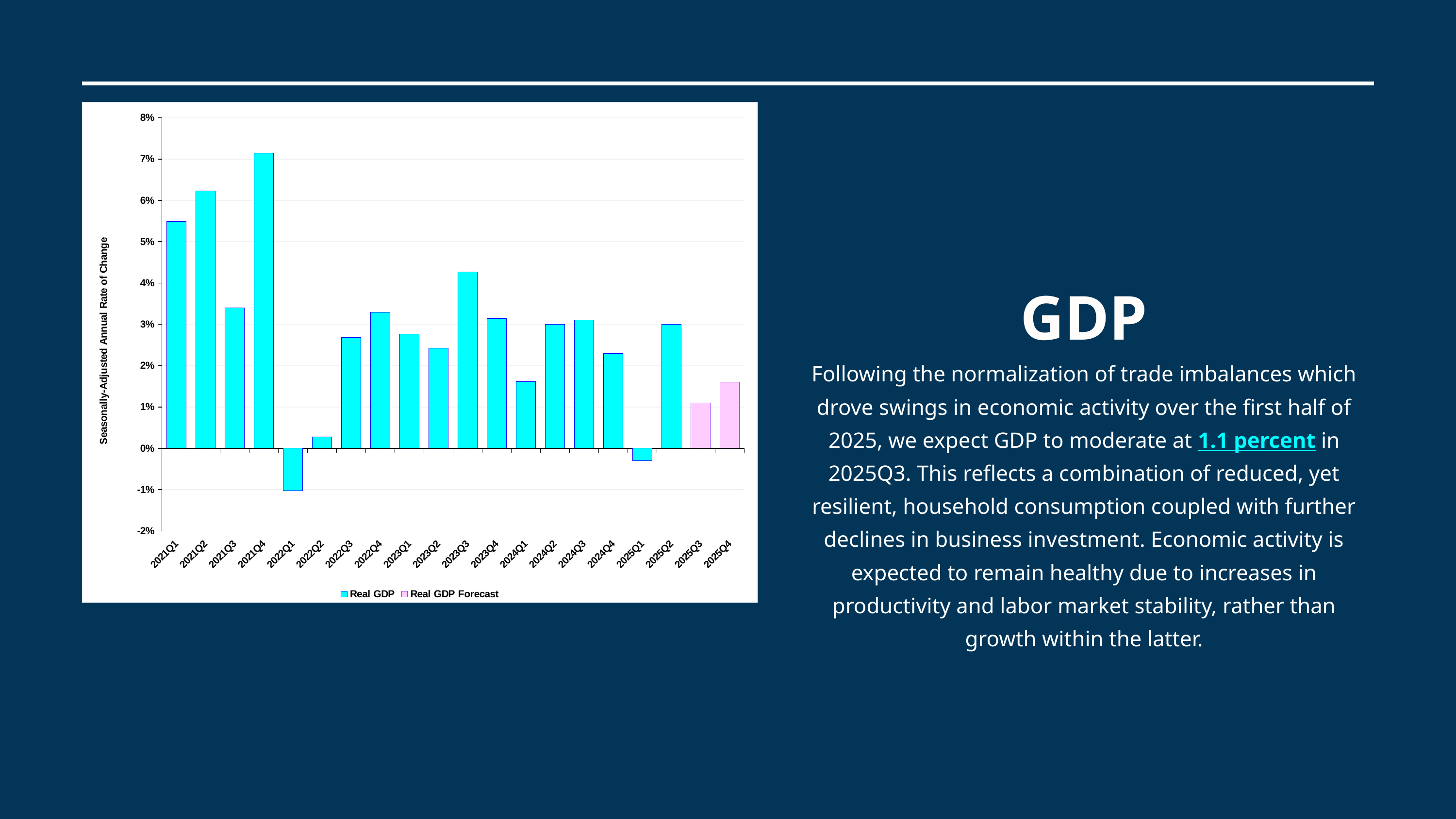
Is the value for 2021Q4 greater or less than 6%? greater Is the value for 2023Q3 greater or less than 4%? greater What are the two series named in the chart's legend? Real GDP and Real GDP Forecast Which quarter has the highest value in the chart? 2021Q4 How many series does the chart's legend list? 2 Which quarter has the lowest value in the chart? 2022Q1 Which is larger, the value for 2025Q3 or the value for 2025Q4? 2025Q4 How many quarters are shown on the x axis of the chart? 20 Which is larger, the value for 2021Q2 or the value for 2021Q3? 2021Q2 Is the value for 2024Q1 greater or less than 2%? less What kind of chart is shown on the slide? bar chart